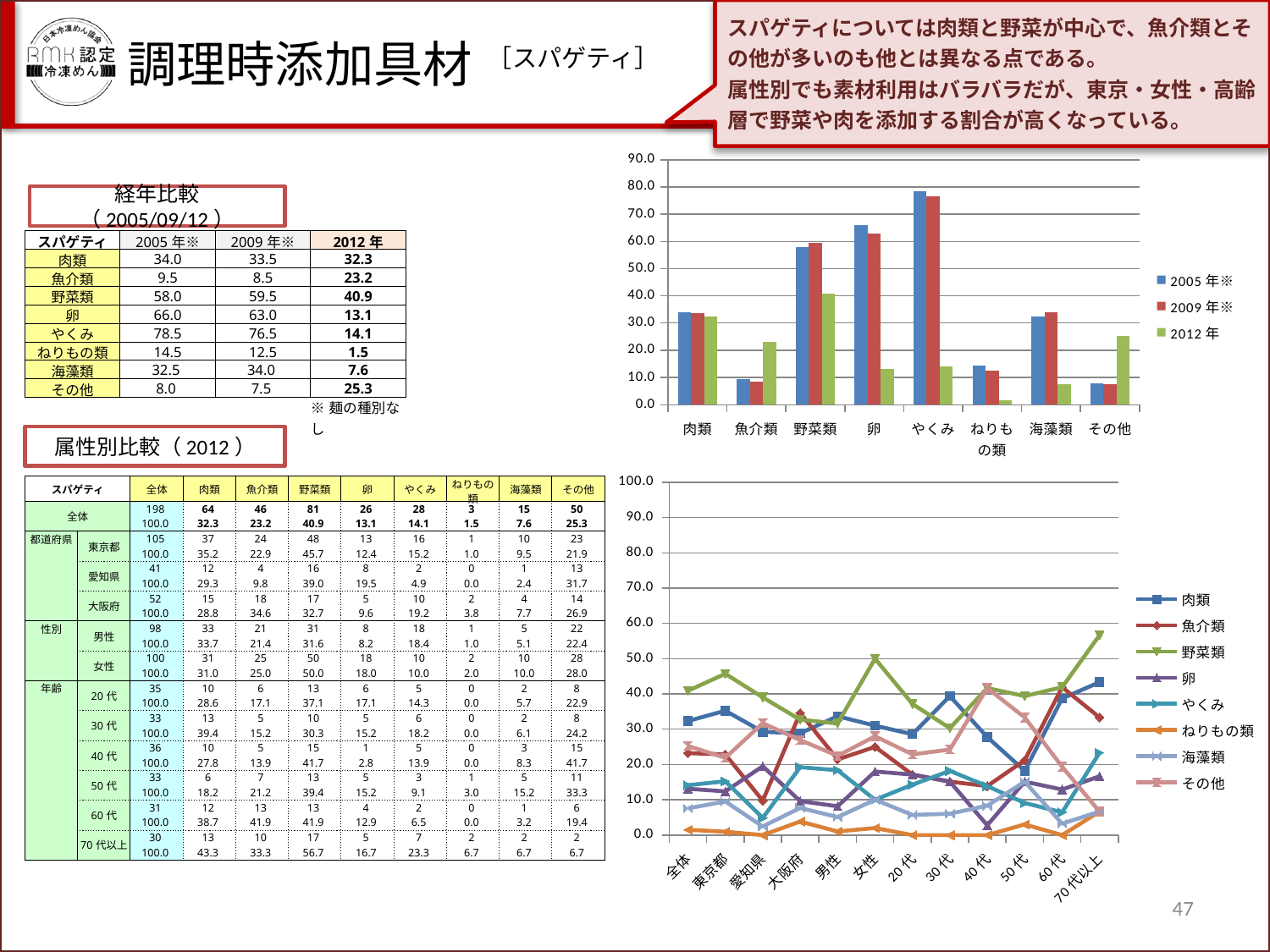
In the top-right bar chart, is the 2005年※ value for 卵 greater or less than 60? greater In the top-right bar chart, how many ingredient categories are shown on the x axis? 8 In the top-right bar chart, which category has the lowest 2012年 bar? ねりもの類 What kind of chart is the top-right chart comparing 2005, 2009 and 2012? bar chart In the top-right bar chart, is the 2012年 value for その他 greater or less than 20? greater In the top-right bar chart, how many series does the legend list? 3 In the top-right bar chart, is the 2012年 value for 野菜類 larger or smaller than the 2012年 value for 卵? larger In the bottom-right line chart, which series reaches the highest point at 70代以上? 野菜類 What kind of chart is the bottom-right chart showing the 2012 attribute comparison? line chart In the bottom-right line chart, how many series does the legend list? 8 In the bottom-right line chart, is the 肉類 value at 70代以上 greater or less than 40? greater In the top-right bar chart, which category has the highest 2005年※ bar? やくみ